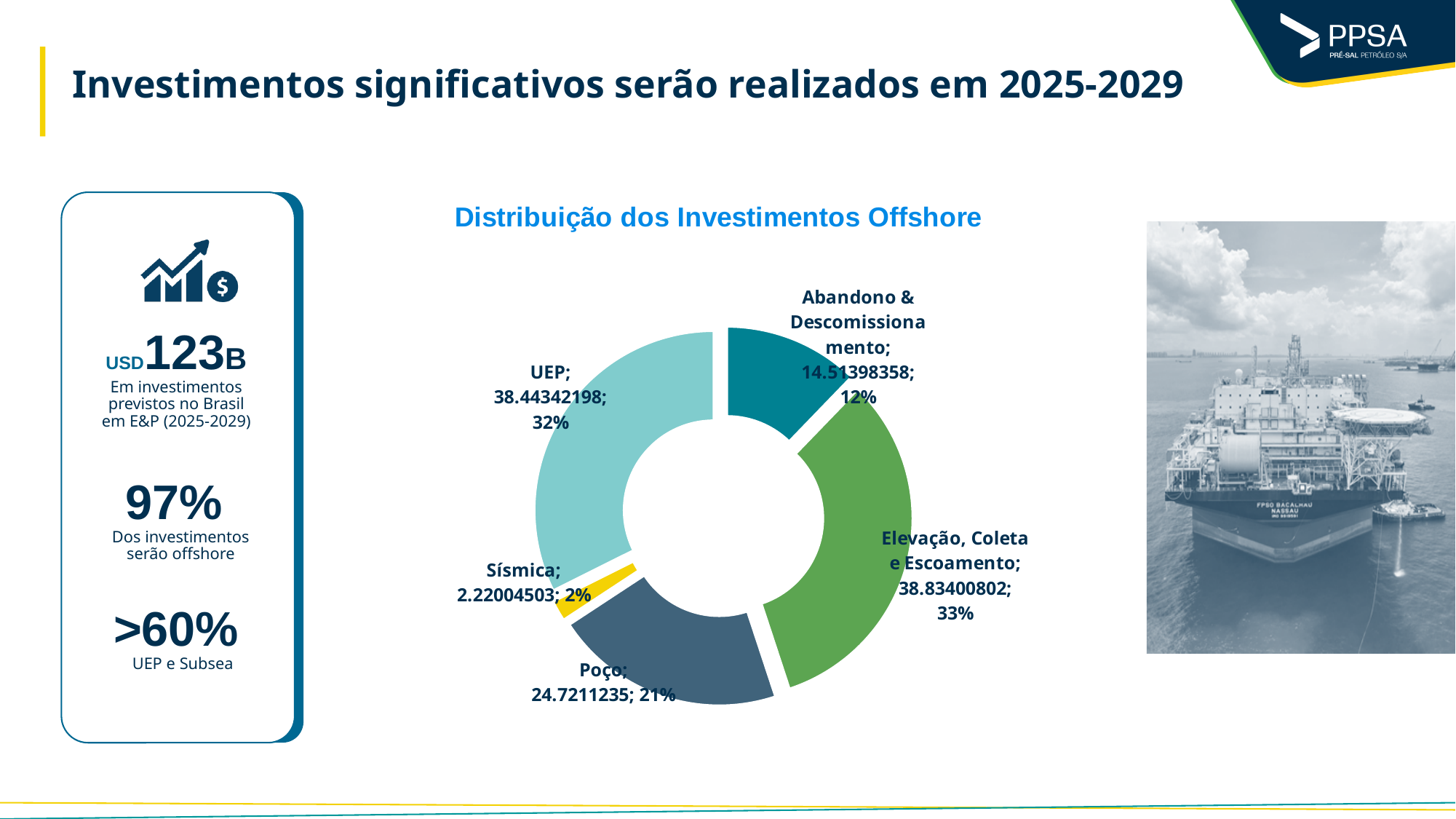
Which category has the largest share in the "Distribuição dos Investimentos Offshore" chart? Elevação, Coleta e Escoamento What percentage share does Elevação, Coleta e Escoamento have in the "Distribuição dos Investimentos Offshore" chart? 33% What value is shown for Sísmica in the "Distribuição dos Investimentos Offshore" chart? 2.22004503 What value is shown for Abandono & Descomissionamento in the "Distribuição dos Investimentos Offshore" chart? 14.51398358 What type of chart is shown under the title "Distribuição dos Investimentos Offshore"? doughnut chart In the "Distribuição dos Investimentos Offshore" chart, which is larger: Poço or Abandono & Descomissionamento? Poço Which category has the smallest share in the "Distribuição dos Investimentos Offshore" chart? Sísmica How many categories are shown in the "Distribuição dos Investimentos Offshore" chart? 5 What value is shown for UEP in the "Distribuição dos Investimentos Offshore" chart? 38.44342198 What percentage share does Poço have in the "Distribuição dos Investimentos Offshore" chart? 21% In the "Distribuição dos Investimentos Offshore" chart, what is the difference in percentage points between Poço (21%) and Sísmica (2%)? 19 percentage points What is the title of the doughnut chart on the slide? Distribuição dos Investimentos Offshore